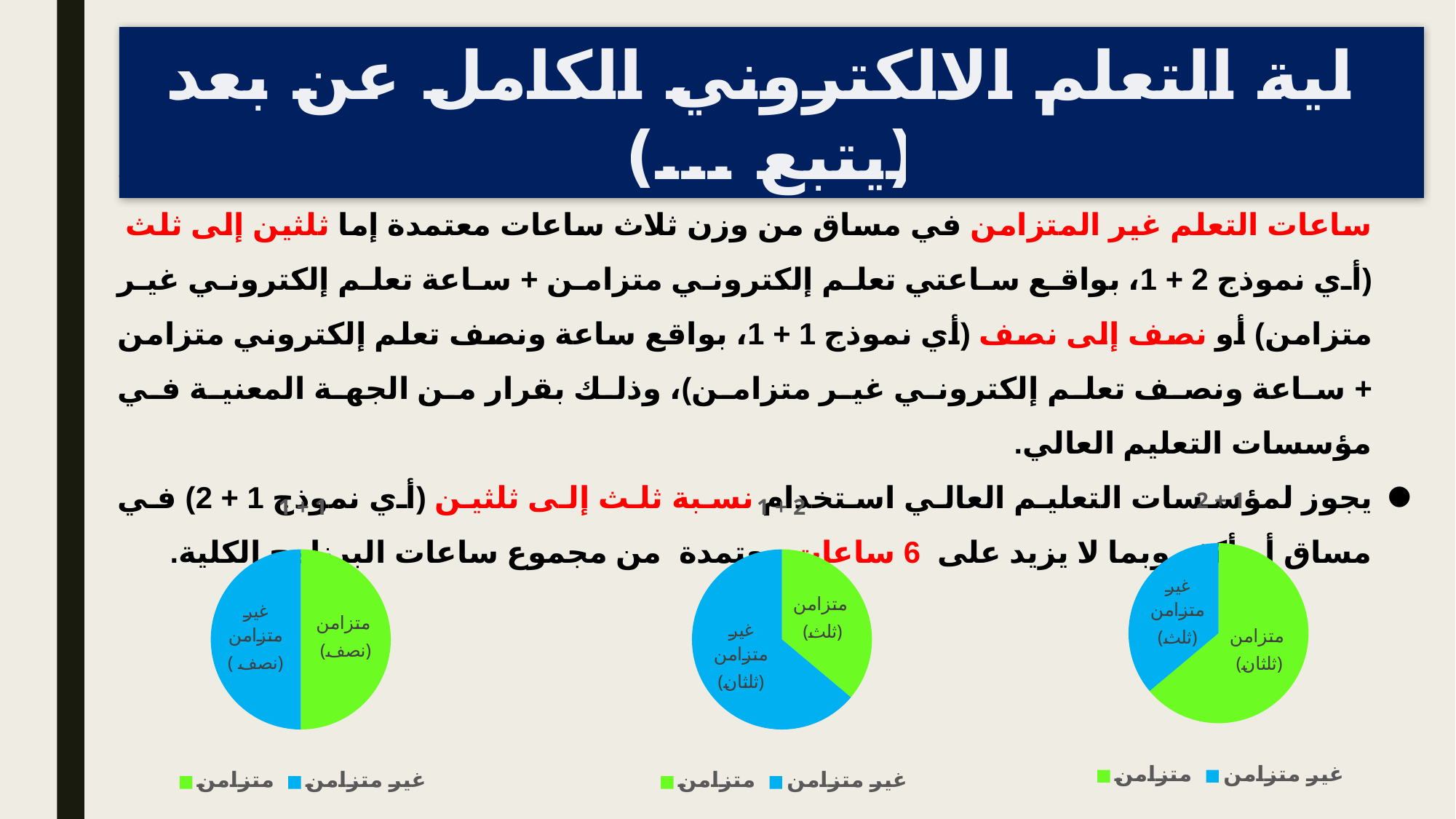
In the right pie chart, which slice is the largest? متزامن In the right pie chart, what share is labelled for the متزامن slice? ثلثان How many slices does the middle pie chart have? 2 What colour is the غير متزامن slice in the pie charts? blue In the right pie chart, which slice is larger: متزامن or غير متزامن? متزامن In the middle pie chart, what share is labelled for the غير متزامن slice? ثلثان In the middle pie chart, which slice is the smallest? متزامن What kind of chart is the left chart on the slide? pie chart In the left pie chart, what share is labelled for the غير متزامن slice? نصف In the middle pie chart, which slice is larger: متزامن or غير متزامن? غير متزامن How many series does the legend of the right pie chart list? 2